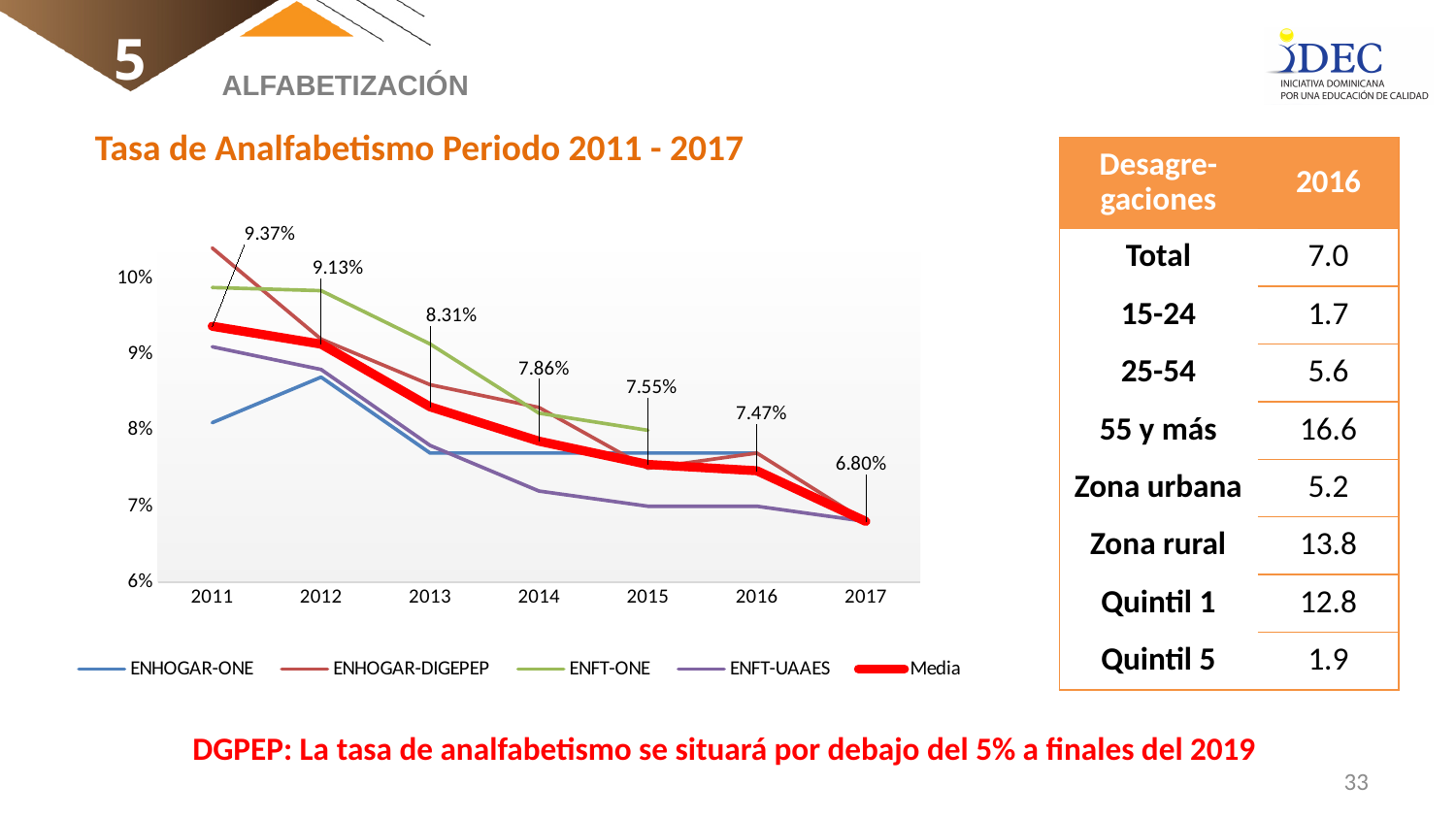
Is the value for ENHOGAR-ONE in 2014 greater or less than 8%? less What is the value of the Media series in 2011? 9.37% What is the difference between the Media value in 2011 and in 2017? 2.57 percentage points In which year is the Media series at its lowest? 2017 How many series does the chart legend list? 5 Is the value for ENHOGAR-DIGEPEP in 2011 greater or less than 10%? greater What is the value of the Media series in 2017? 6.80% Does the Media series rise or fall from 2011 to 2017? It falls What is the value of the Media series in 2014? 7.86% In which year is the Media series at its highest? 2011 Which is larger for the Media series: the 2013 value or the 2015 value? 2013 (8.31%) How many years are shown on the x axis of the chart? 7